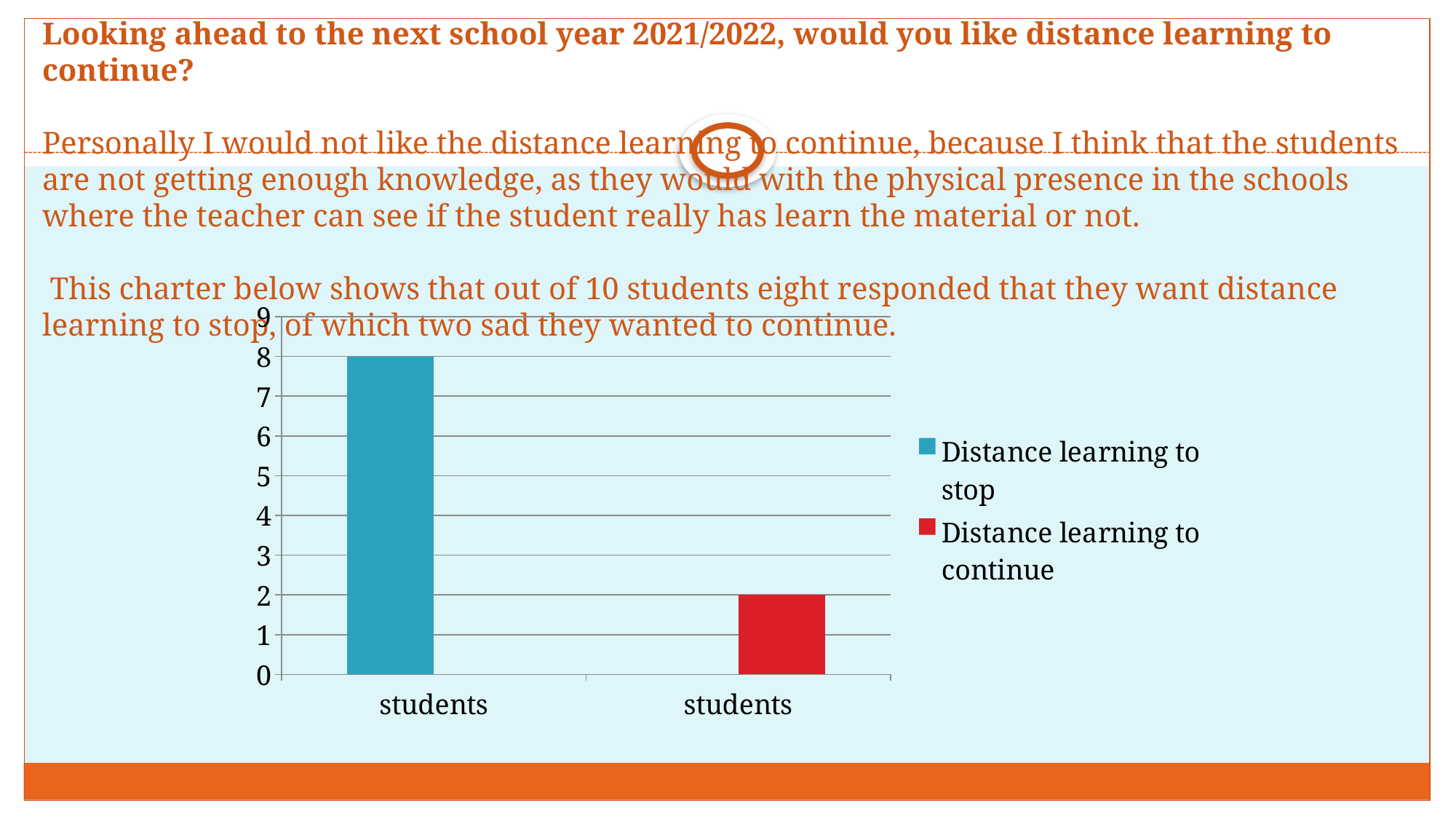
Which is larger, the value for "Distance learning to stop" or for "Distance learning to continue"? Distance learning to stop How many bars are plotted in the chart? 2 What is the difference between the values for "Distance learning to stop" and "Distance learning to continue"? 6 Which series has the lowest bar? Distance learning to continue What is the highest value shown on the vertical axis? 9 How many series does the legend list? 2 What is the value of the bar for "Distance learning to continue"? 2 What colour is the bar for "Distance learning to continue"? red What kind of chart is shown on the slide? bar chart Is the value for "Distance learning to stop" greater or less than 5? greater What is the value of the bar for "Distance learning to stop"? 8 Which series has the highest bar? Distance learning to stop